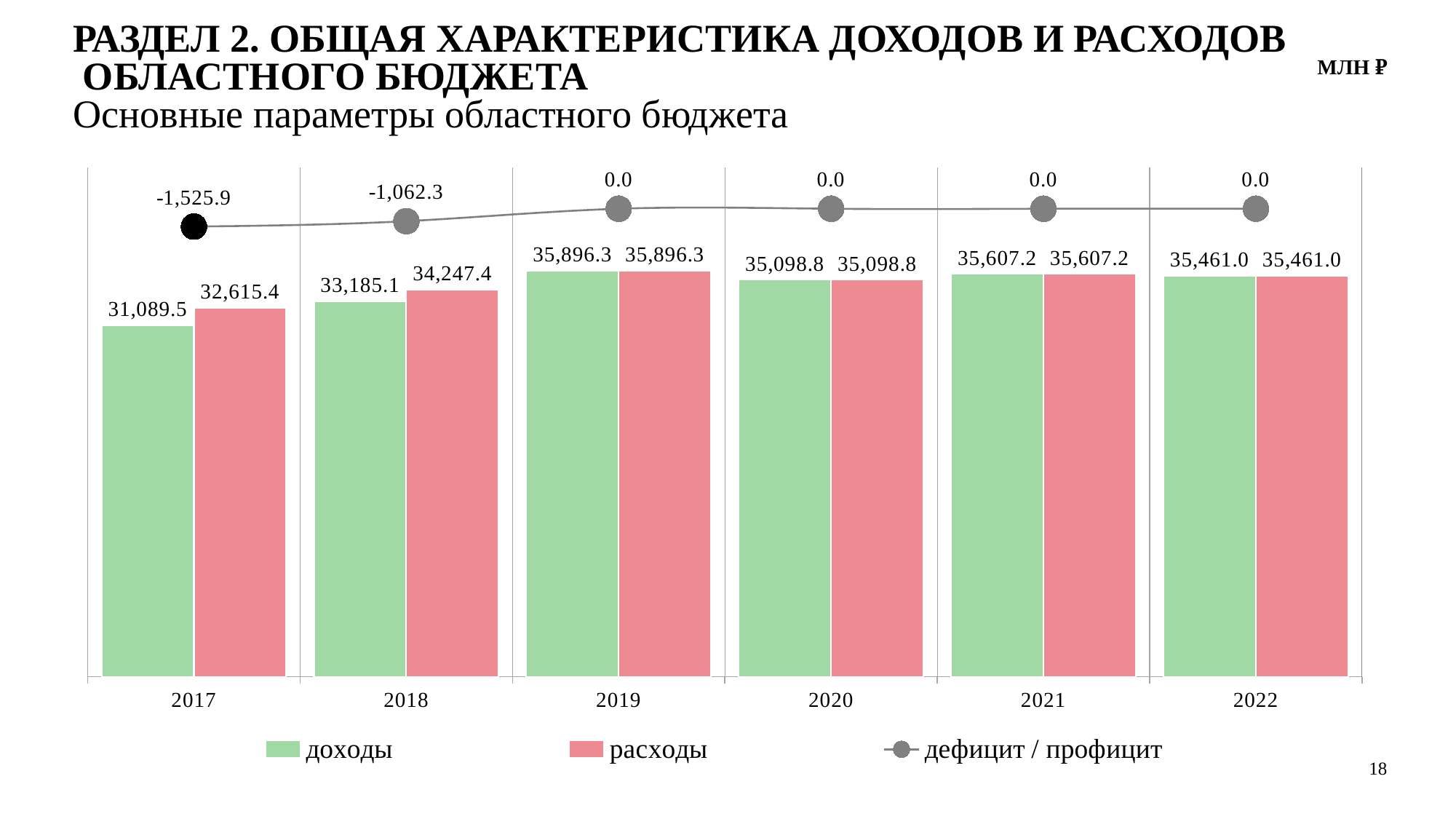
How many series does the legend list? 3 What is the value of доходы for 2017? 31,089.5 What is the value of дефицит / профицит for 2017? -1,525.9 In which year is расходы lowest? 2017 In which year is доходы highest? 2019 What is the value of расходы for 2018? 34,247.4 What is the value of дефицит / профицит for 2018? -1,062.3 What kind of chart is this? Combined bar and line chart What unit is indicated in the top right corner of the slide? млн ₽ How many years are shown on the x axis? 6 What is the difference between расходы and доходы in 2017? 1,525.9 Which is larger in 2018: доходы or расходы? расходы